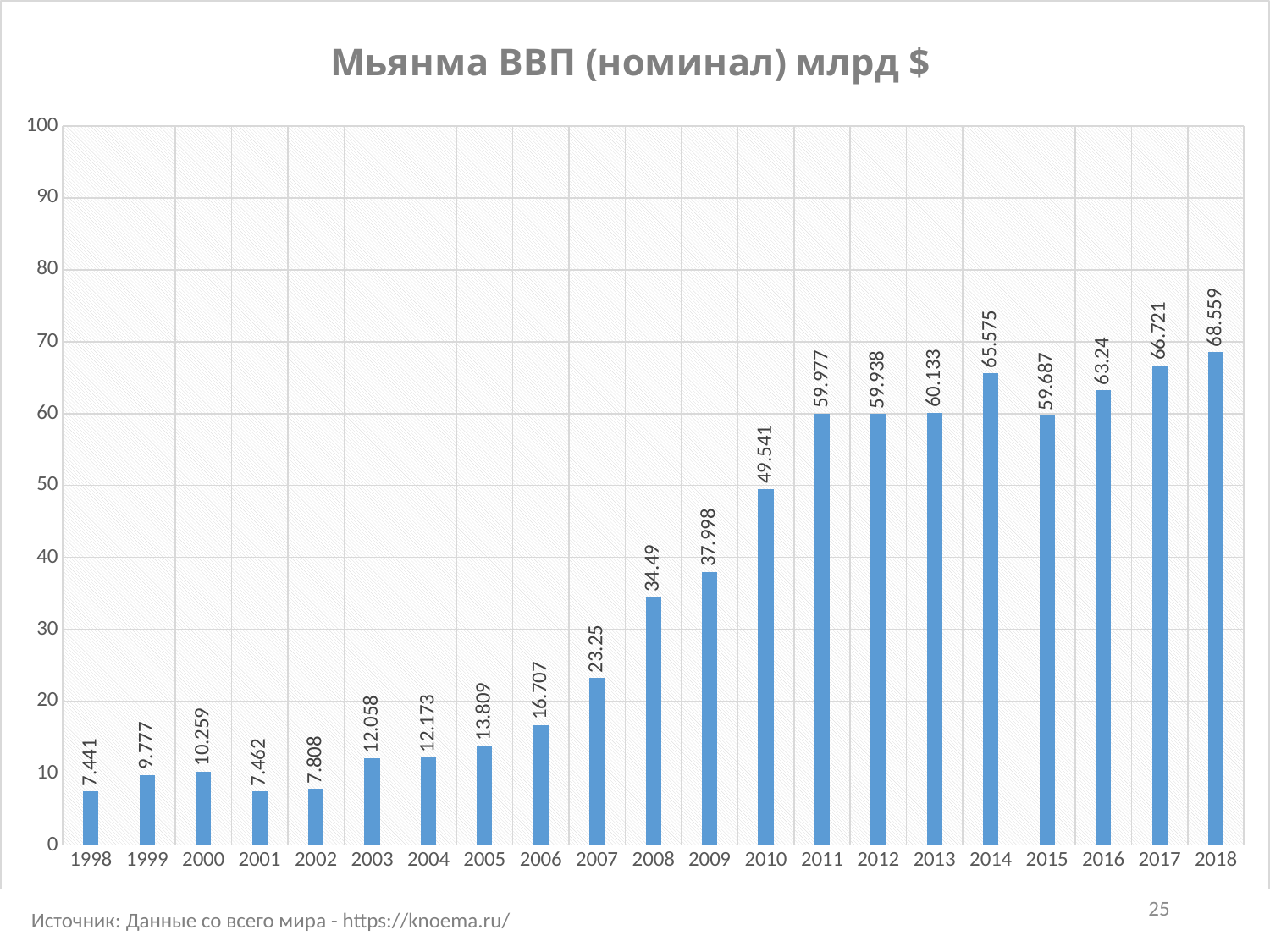
What is the value for 2003? 12.058 What is the value for 2018? 68.559 Which year has the lowest value? 1998 What is the difference between the values for 2010 and 2009? 11.543 Which is larger, the value for 2014 or the value for 2015? 2014 Do the values generally rise or fall from 1998 to 2018? rise Is the value for 2008 greater or less than 30? greater What is the value for 2010? 49.541 How many years are shown on the x axis? 21 Which year has the highest value? 2018 What kind of chart is this? bar chart What is the difference between the values for 2018 and 2017? 1.838